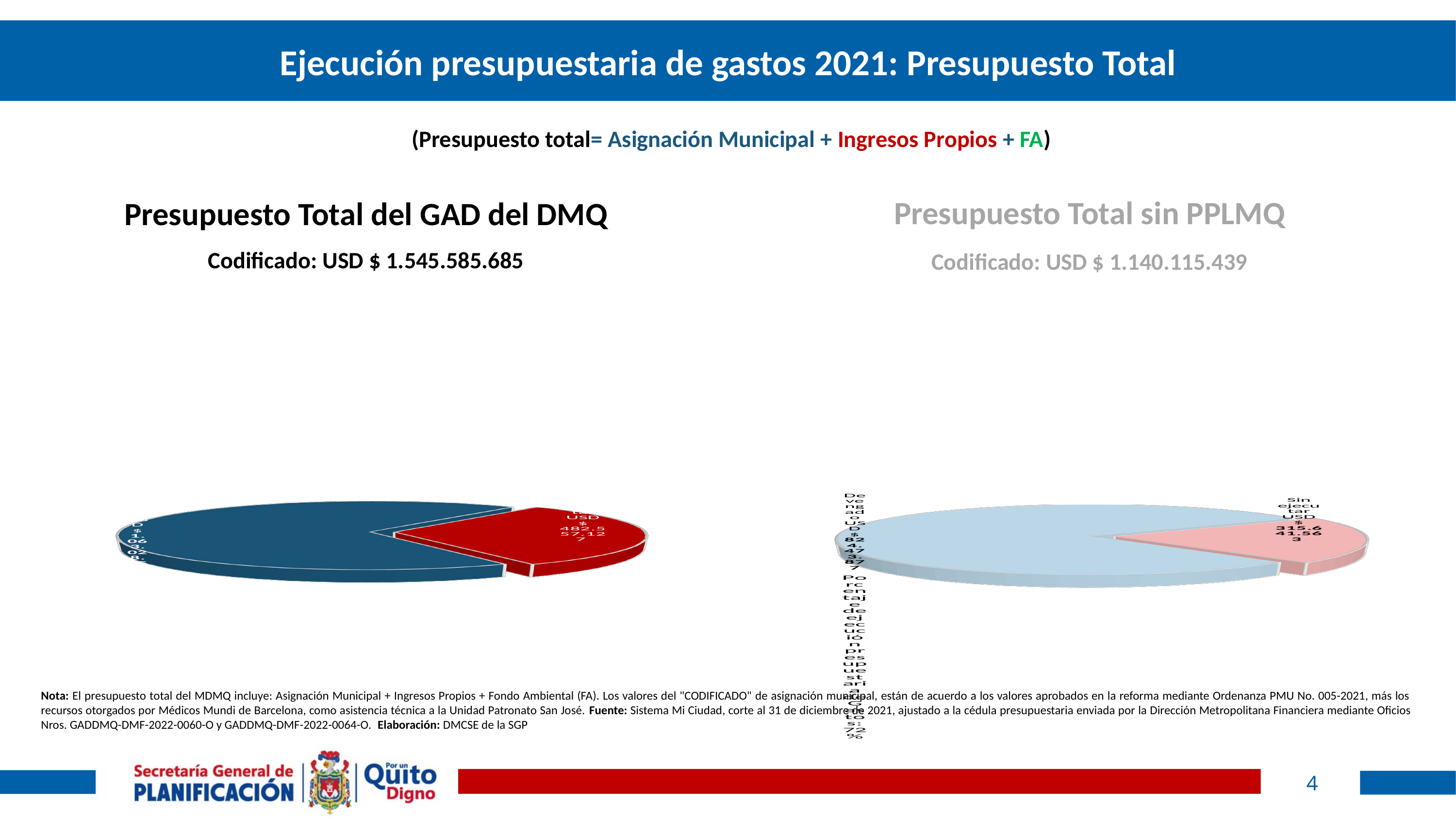
In the 'Presupuesto Total del GAD del DMQ' pie chart, which slice is the smallest? Sin ejecutar In the 'Presupuesto Total sin PPLMQ' pie chart, which slice is larger, the light blue 'Devengado' one or the pink 'Sin ejecutar' one? The light blue 'Devengado' one In the 'Presupuesto Total sin PPLMQ' pie chart, how many slices are there? 2 What kind of chart is used for 'Presupuesto Total sin PPLMQ'? Pie chart In the 'Presupuesto Total del GAD del DMQ' pie chart, which slice is larger, the dark blue one or the red 'Sin ejecutar' one? The dark blue one What colour is the 'Sin ejecutar' slice in the 'Presupuesto Total sin PPLMQ' pie chart? Pink In the 'Presupuesto Total del GAD del DMQ' pie chart, how many slices are there? 2 What 'Codificado' amount is shown above the 'Presupuesto Total del GAD del DMQ' chart? USD $ 1.545.585.685 In the 'Presupuesto Total sin PPLMQ' pie chart, which slice is the smallest? Sin ejecutar What kind of chart is used for 'Presupuesto Total del GAD del DMQ'? Pie chart In the 'Presupuesto Total sin PPLMQ' pie chart, what value is shown for the 'Sin ejecutar' slice? USD $ 315.641.563 In the 'Presupuesto Total del GAD del DMQ' pie chart, what value is shown for the 'Sin ejecutar' slice? USD $ 482.557,127